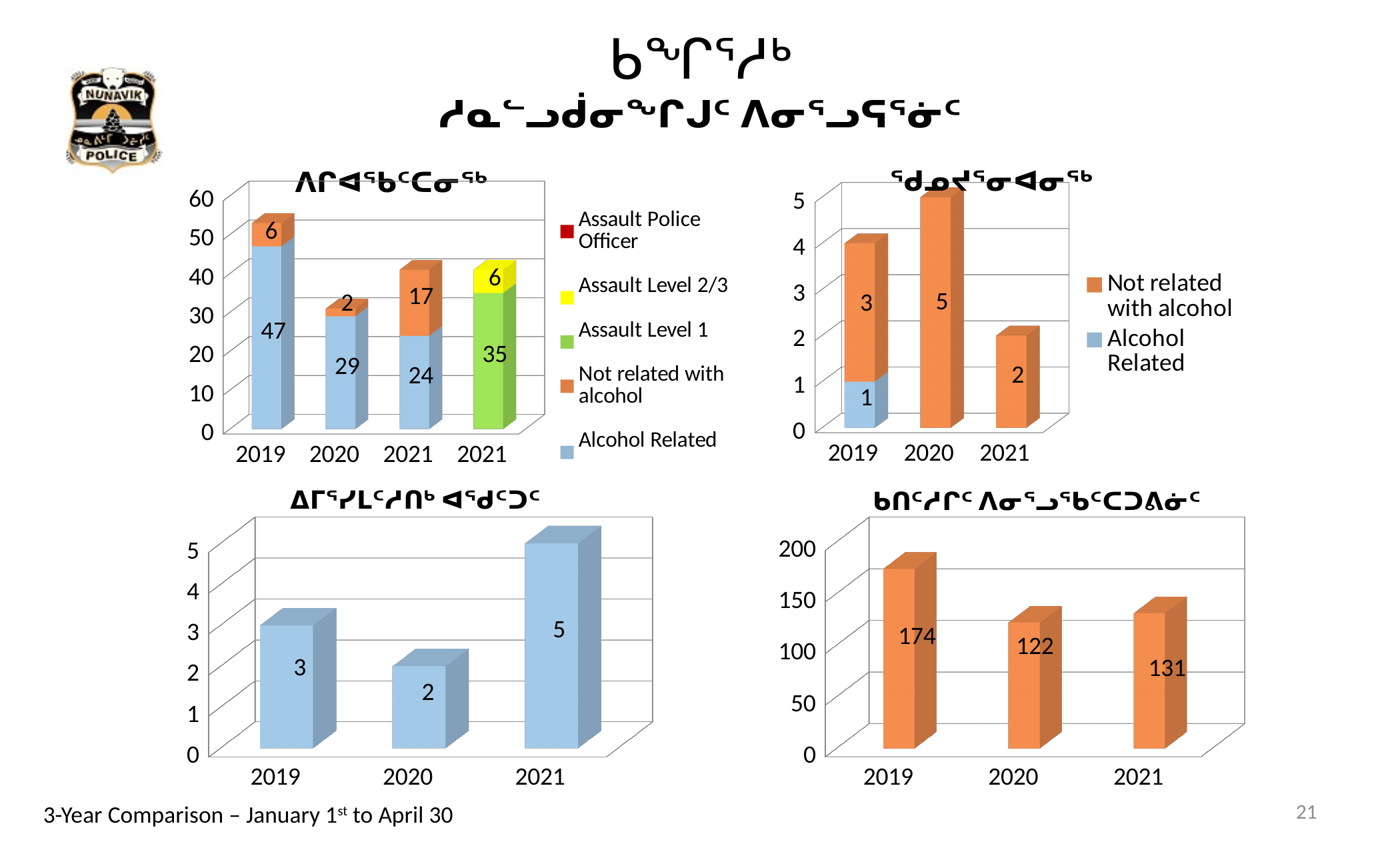
In the top-left chart, what is the Not related with alcohol value for 2021 (the third bar)? 17 In the top-left chart, what is the Alcohol Related value for 2019? 47 In the bottom-left chart, which year has the highest value? 2021 In the bottom-right chart, which year has the lowest value? 2020 In the top-left chart, what is the Assault Level 1 value for the rightmost 2021 bar? 35 In the top-right chart, what is the Not related with alcohol value for 2020? 5 In the bottom-right chart, what is the difference between the values for 2019 and 2020? 52 How many series does the legend of the top-left chart list? 5 In the top-right chart, what is the total of the stacked bar for 2019? 4 In the top-left chart, what is the total of the stacked bar for 2019? 53 What kind of chart is the bottom-right chart? bar chart In the bottom-left chart, what is the value for 2020? 2